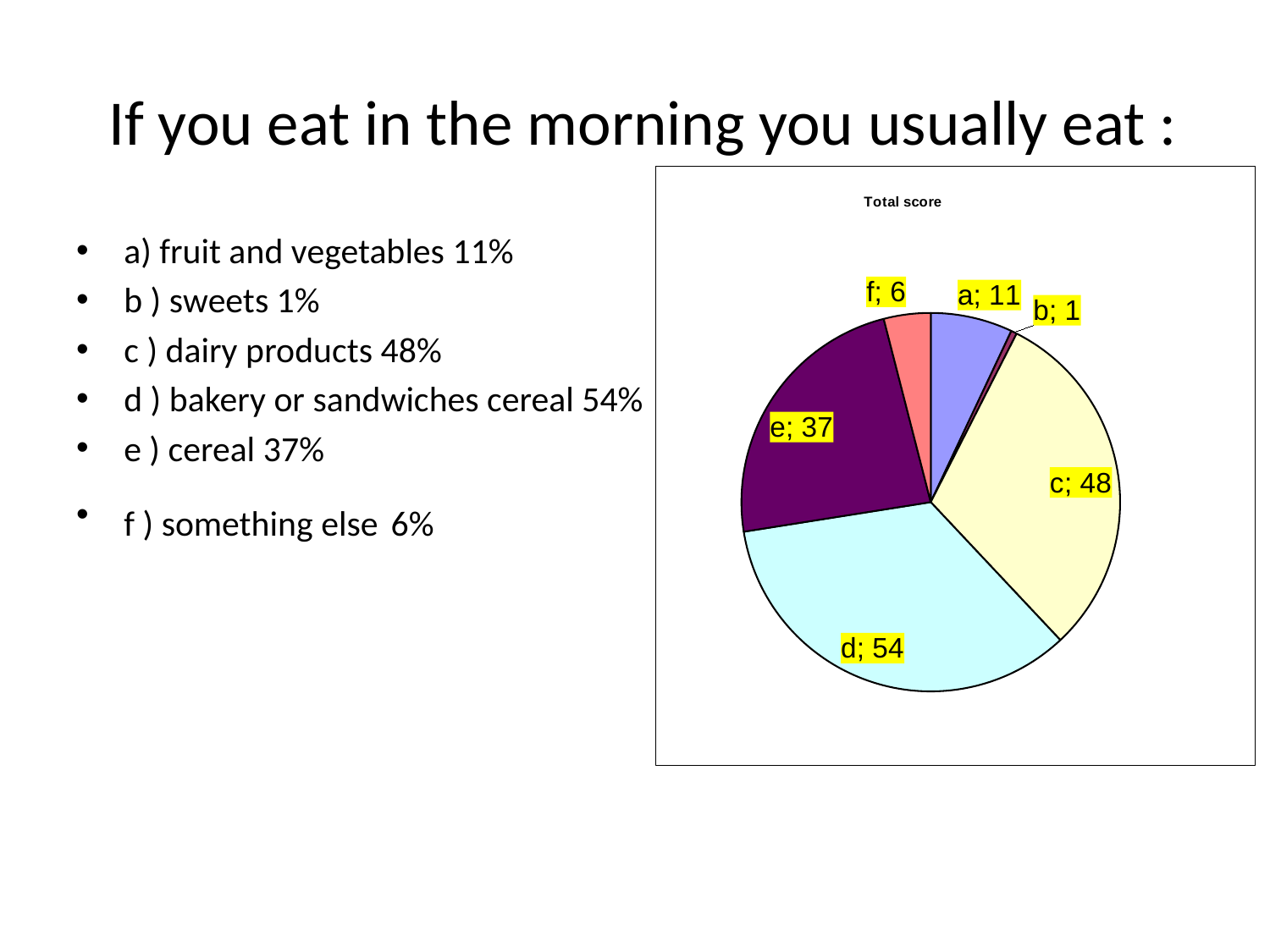
What is the value for category e in the pie chart? 37 What is the value for category c in the pie chart? 48 What is the difference between the values for d and c? 6 What is the sum of all the values shown in the pie chart? 157 What is the value for category b in the pie chart? 1 What is the value for category d in the pie chart? 54 How many slices does the pie chart have? 6 Which is larger, the value for a or the value for f? a Which category has the smallest slice in the pie chart? b What is the title of the chart? Total score What type of chart is shown on the slide? pie chart Which category has the largest slice in the pie chart? d